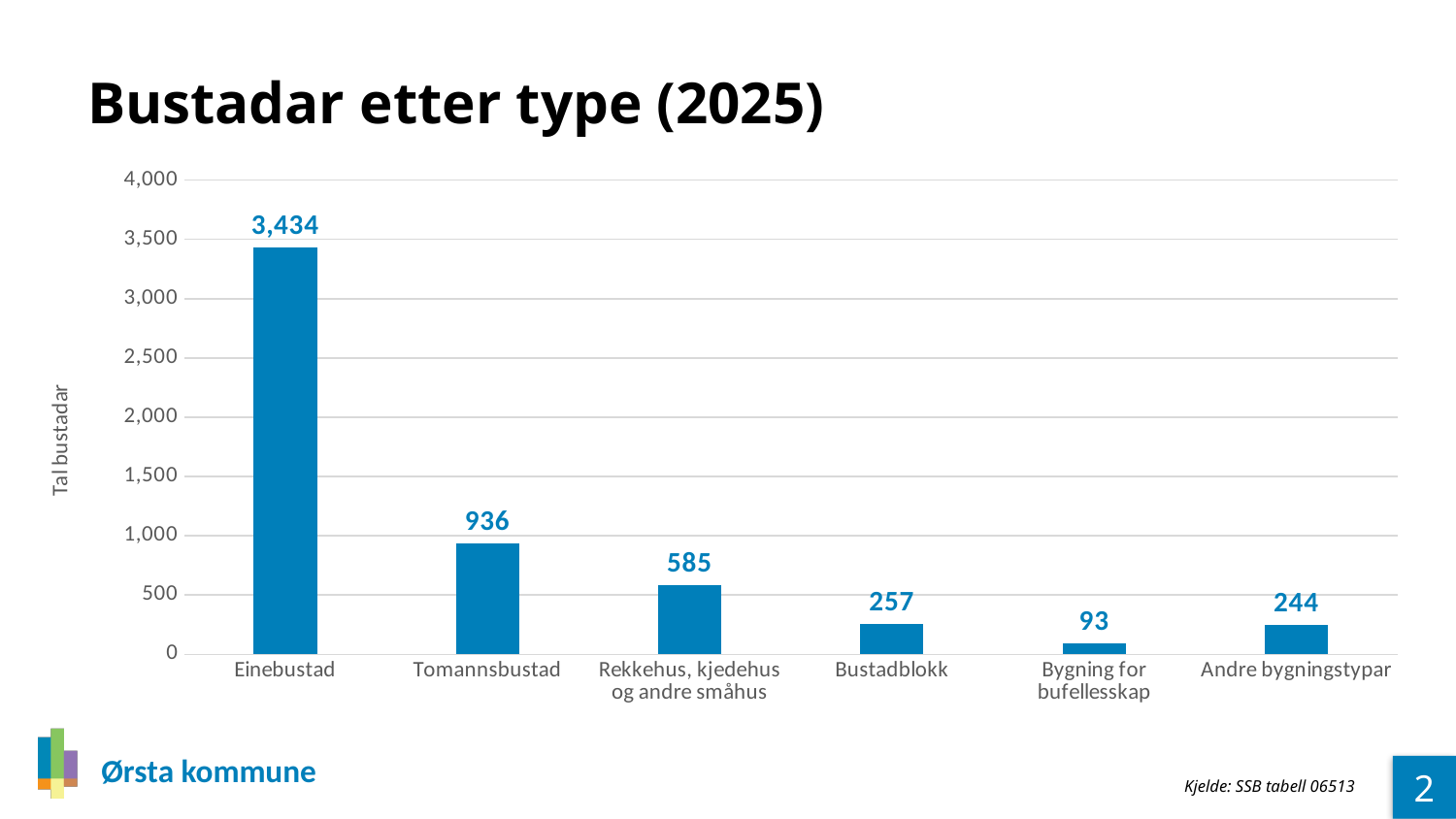
What is the label of the y axis? Tal bustadar What is the value for Bygning for bufellesskap? 93 What is the value for Tomannsbustad? 936 What is the difference between Tomannsbustad and Rekkehus, kjedehus og andre småhus? 351 Which category has the lowest value? Bygning for bufellesskap What is the title of the chart? Bustadar etter type (2025) What is the value for Andre bygningstypar? 244 Which category has the highest value? Einebustad Which is larger, Bustadblokk or Andre bygningstypar? Bustadblokk What kind of chart is this? Bar chart What is the value for Einebustad? 3,434 How many categories are shown on the x axis? 6